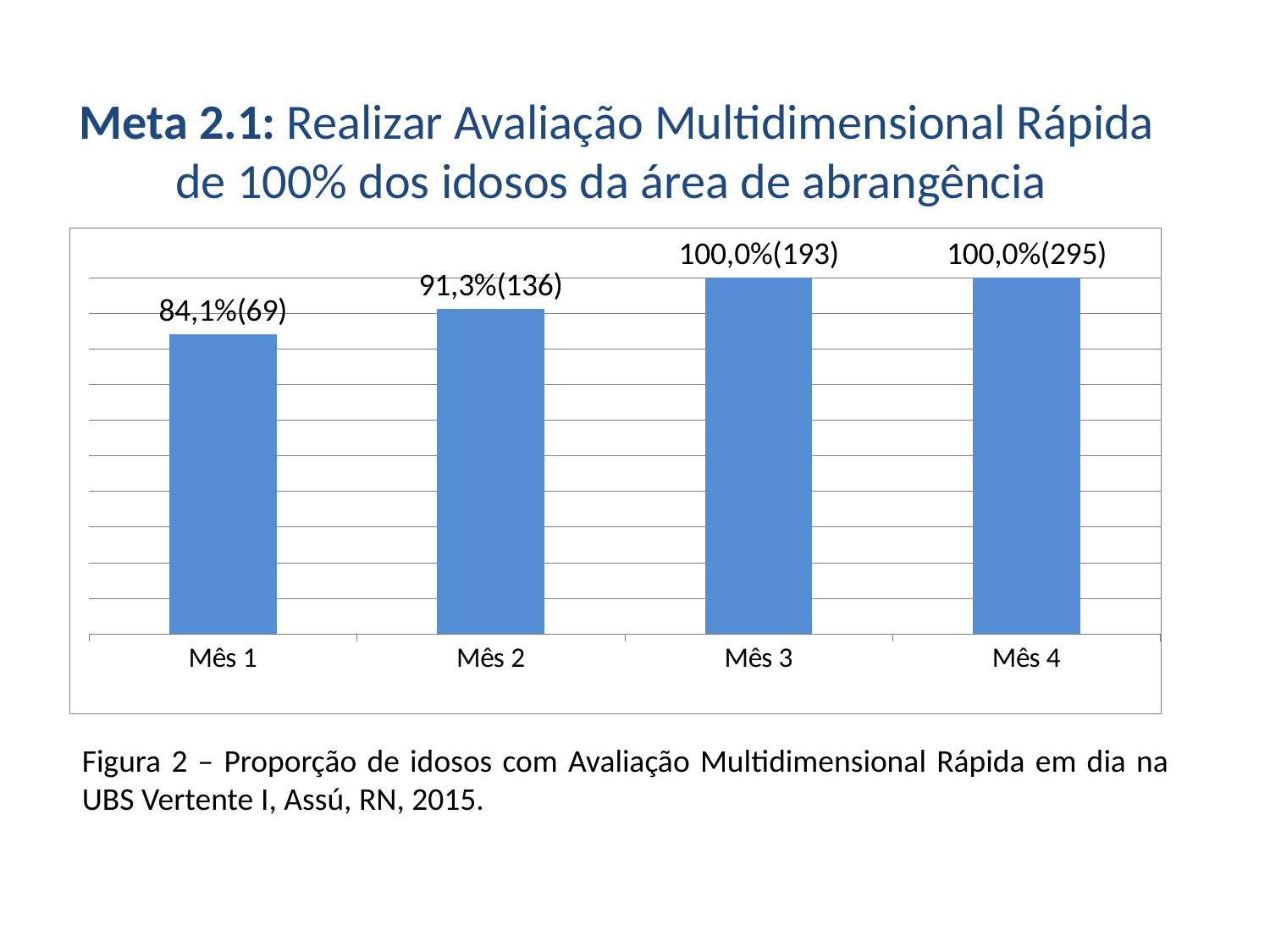
Which has a higher percentage, Mês 1 or Mês 2? Mês 2 What is the difference in percentage points between Mês 2 and Mês 1? 7,2 How many months (categories) are shown on the x axis? 4 Do the percentages rise or fall from Mês 1 to Mês 4? Rise What is the data label shown for Mês 2? 91,3%(136) What is the data label shown for Mês 1? 84,1%(69) What is the figure caption number given below the chart? Figura 2 What percentage is shown for Mês 3? 100,0% What is the difference between the numbers in parentheses for Mês 4 and Mês 3? 102 Which month has the lowest percentage? Mês 1 What number in parentheses is shown for Mês 4? 295 What kind of chart is shown on the slide? Bar chart